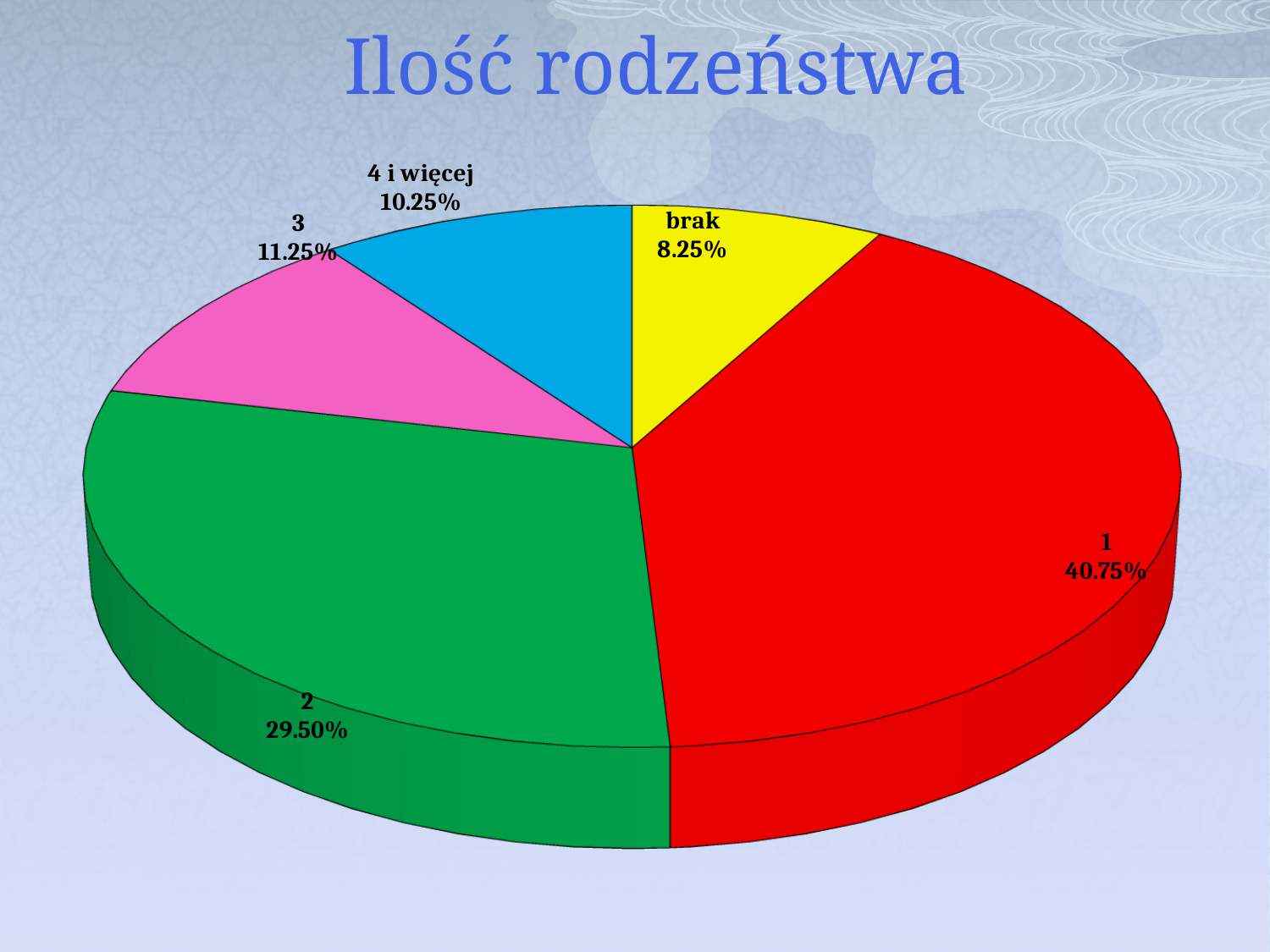
What colour is the slice for the category "2"? green What percentage is shown for the category "2"? 29.50% Which category has the largest share of the pie? 1 What percentage is shown for the category "brak"? 8.25% Which category has the smallest share of the pie? brak What percentage is shown for the category "1"? 40.75% What is the difference between the shares for "1" and "2"? 11.25% What is the title of the chart? Ilość rodzeństwa What percentage is shown for the category "4 i więcej"? 10.25% How many slices does the pie chart have? 5 Which is larger, the share for "3" or the share for "4 i więcej"? 3 What kind of chart is shown on the slide? pie chart